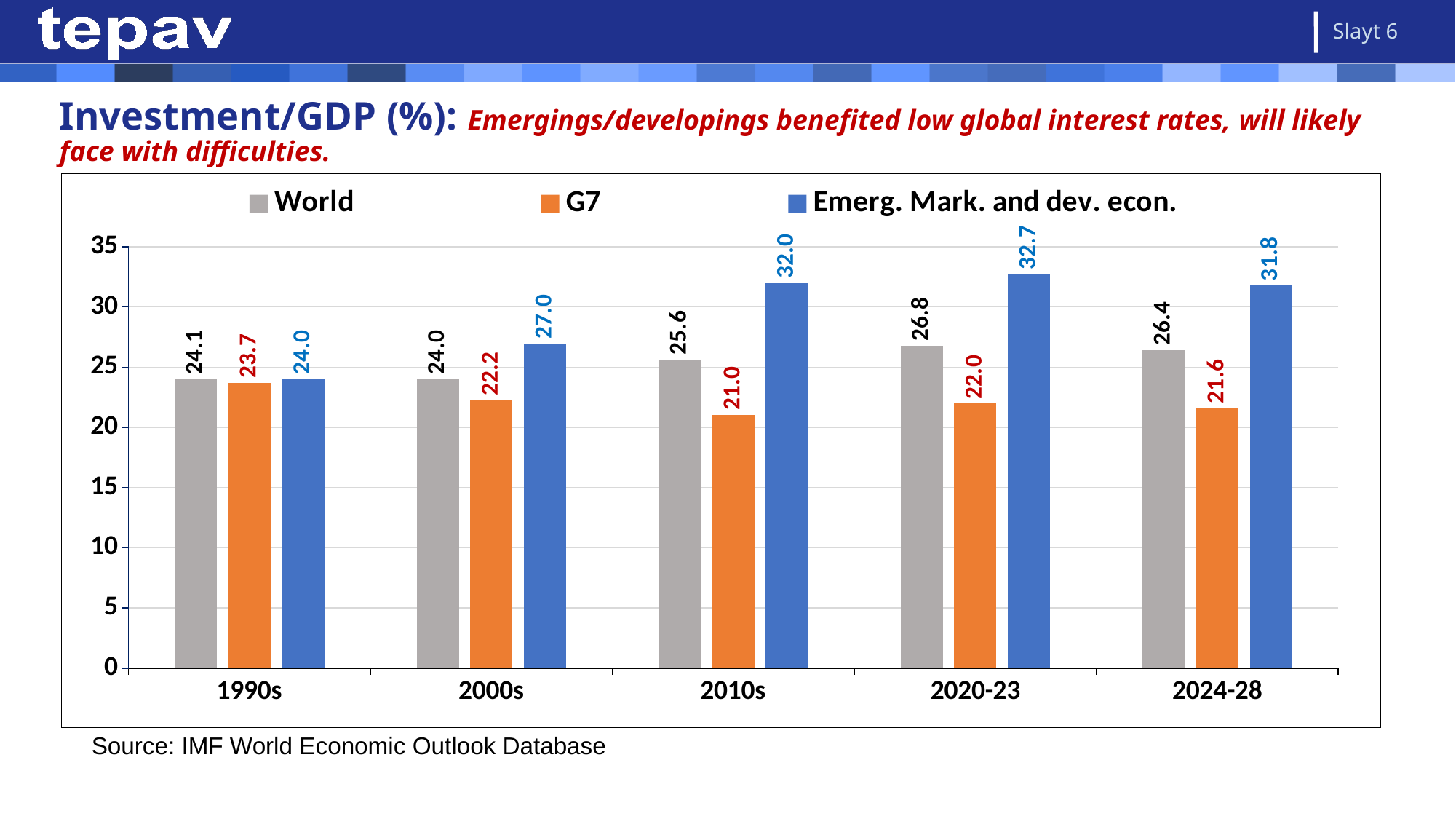
What is the World investment/GDP value for the 2010s? 25.6 What is the difference between the Emerg. Mark. and dev. econ. value and the G7 value in 2020-23? 10.7 Which colour represents the G7 series in the chart? Orange In which period is the Emerg. Mark. and dev. econ. value highest? 2020-23 How many periods are shown on the x axis? 5 In which period is the G7 value lowest? 2010s How many series does the legend list? 3 What kind of chart is shown on the slide? Bar chart What is the value for Emerg. Mark. and dev. econ. in the 2000s? 27.0 What is the G7 value for 2024-28? 21.6 Which is larger in the 1990s: the World value or the G7 value? World Does the G7 value rise or fall from the 1990s to the 2010s? Fall